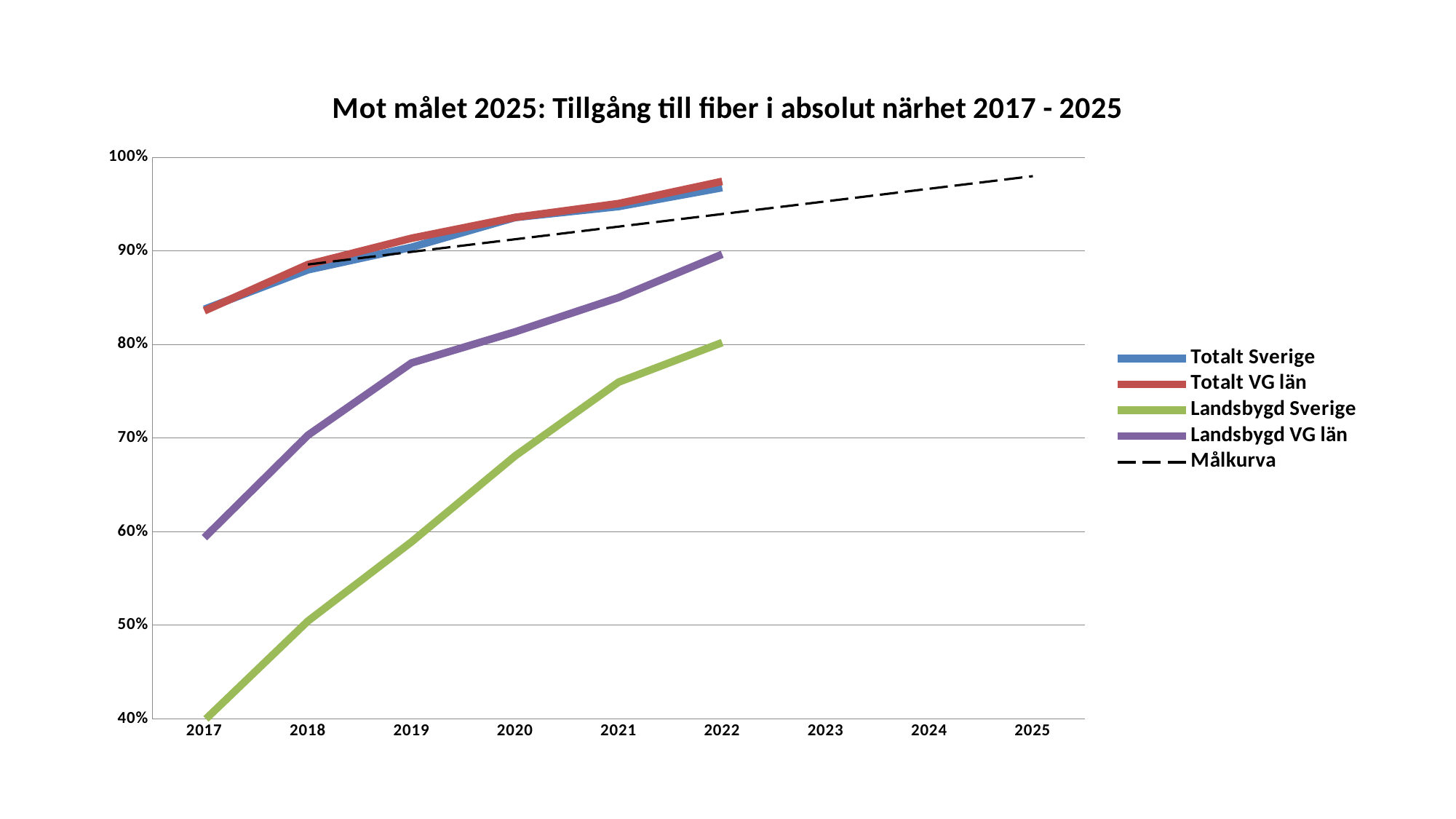
Which series has the lowest value in 2017? Landsbygd Sverige Is the value for Landsbygd VG län in 2019 greater or less than 80%? less Is the value for Landsbygd Sverige in 2021 greater or less than 70%? greater What is the title of the chart? Mot målet 2025: Tillgång till fiber i absolut närhet 2017 - 2025 Do the values for Landsbygd Sverige rise or fall from 2017 to 2022? rise How many series does the legend list? 5 Is the value for Totalt VG län in 2022 greater or less than 90%? greater Which series is drawn as a dashed line? Målkurva How many years are shown on the x axis? 9 What kind of chart is shown on the slide? line chart In 2022, which is higher: Landsbygd VG län or Landsbygd Sverige? Landsbygd VG län